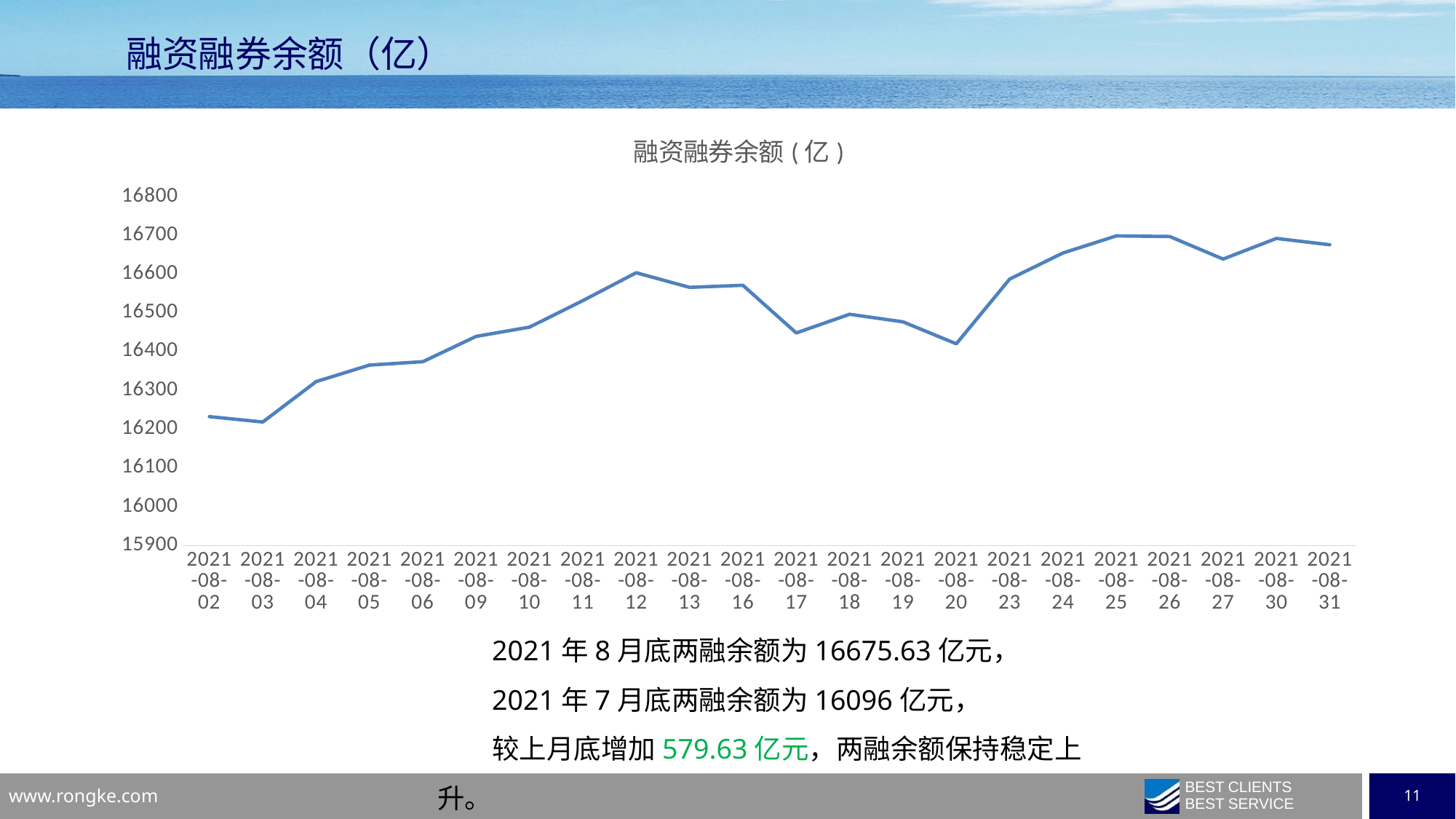
Overall, do the values rise or fall from 2021-08-02 to 2021-08-31? rise Which is larger, the value for 2021-08-12 or the value for 2021-08-20? 2021-08-12 Is the value for 2021-08-17 greater or less than 16500? less Is the value for 2021-08-02 greater or less than 16300? less Is the value for 2021-08-27 greater or less than 16600? greater Which is larger, the value for 2021-08-02 or the value for 2021-08-31? 2021-08-31 According to the text below the chart, what was the 两融余额 at the end of August 2021? 16675.63 亿元 What is the title of the chart? 融资融券余额（亿） How many dates are plotted along the x axis of the chart? 22 What kind of chart is shown on the slide? line chart